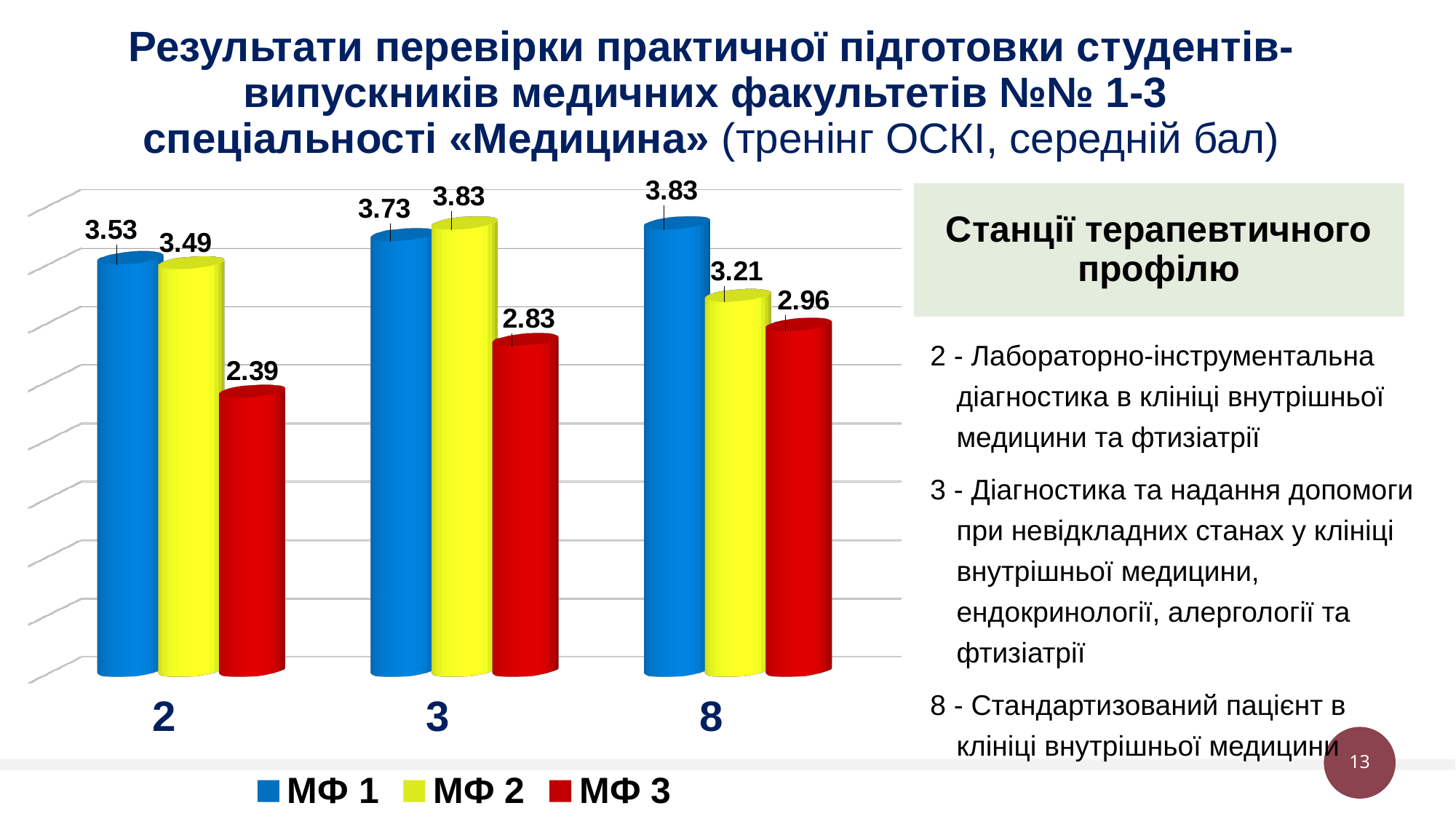
What is the value for МФ 3 at station 3? 2.83 How many series does the legend list? 3 What is the value for МФ 2 at station 8? 3.21 Which series has the highest value at station 3? МФ 2 What is the difference between МФ 1 and МФ 3 at station 8? 0.87 What kind of chart is shown on the slide? Bar chart How many categories (stations) are shown on the x axis? 3 Which series has the lowest value at station 2? МФ 3 What is the value for МФ 1 at station 2? 3.53 What is the difference between МФ 2 and МФ 3 at station 2? 1.10 Which is larger at station 8: МФ 1 or МФ 2? МФ 1 At which station does МФ 3 have its lowest value? 2